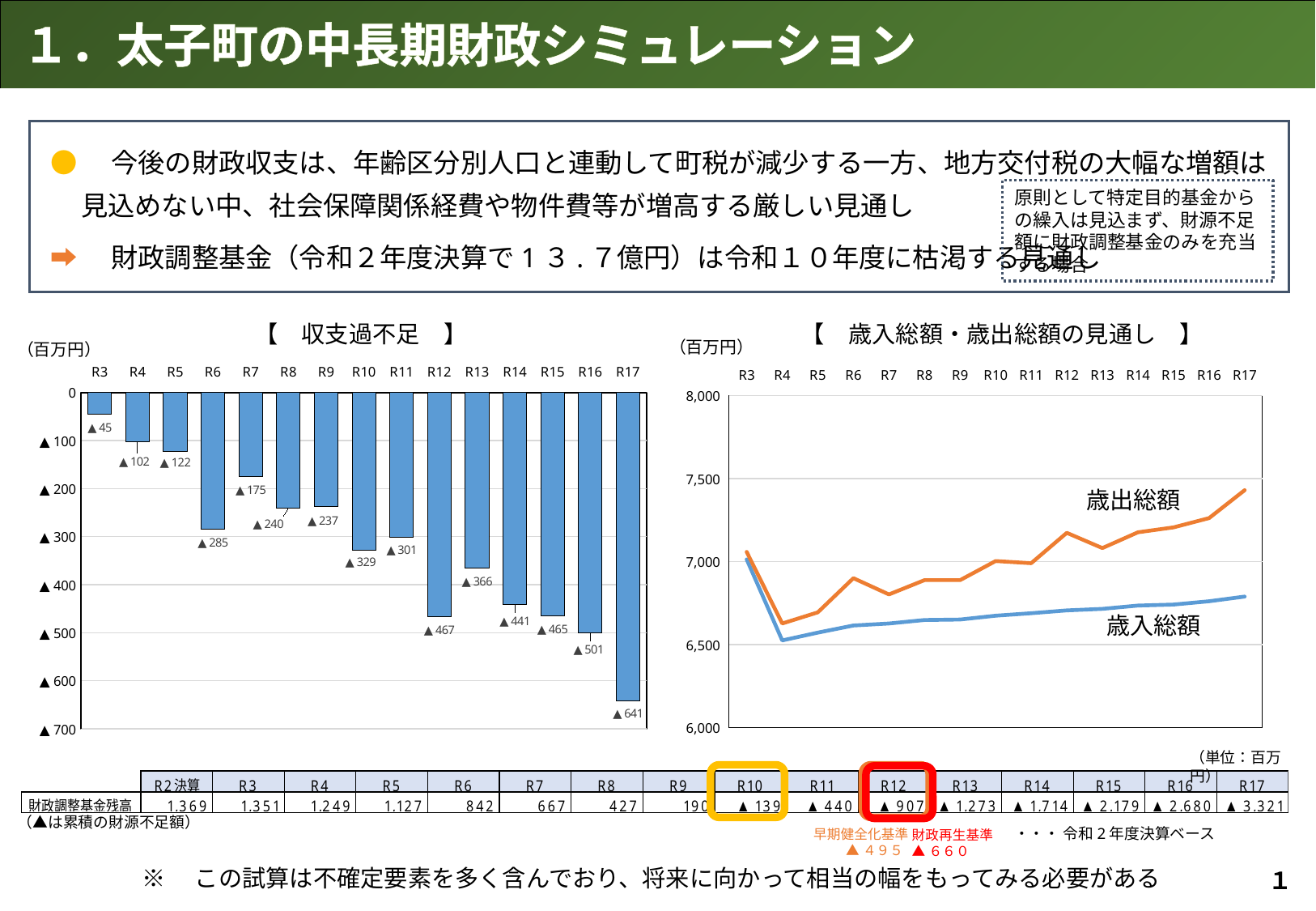
How many series are plotted in the 歳入総額・歳出総額の見通し chart? 2 What kind of chart is the 収支過不足 chart? Bar chart In the 歳入総額・歳出総額の見通し chart, does 歳出総額 rise or fall overall from R4 to R17? rises In the 収支過不足 chart, what is the value shown for R3? ▲45 In the 収支過不足 chart, by how much does the shortfall for R17 exceed that for R3? 596 How many years are plotted in the 収支過不足 chart? 15 In the 収支過不足 chart, which year has the larger shortfall, R6 or R7? R6 In the 歳入総額・歳出総額の見通し chart, is the value of 歳出総額 at R17 greater or less than 7,000? greater In the 収支過不足 chart, which year has the smallest shortfall? R3 In the 収支過不足 chart, what is the value shown for R12? ▲467 In the 収支過不足 chart, what is the value shown for R17? ▲641 In the 収支過不足 chart, which year has the largest shortfall? R17